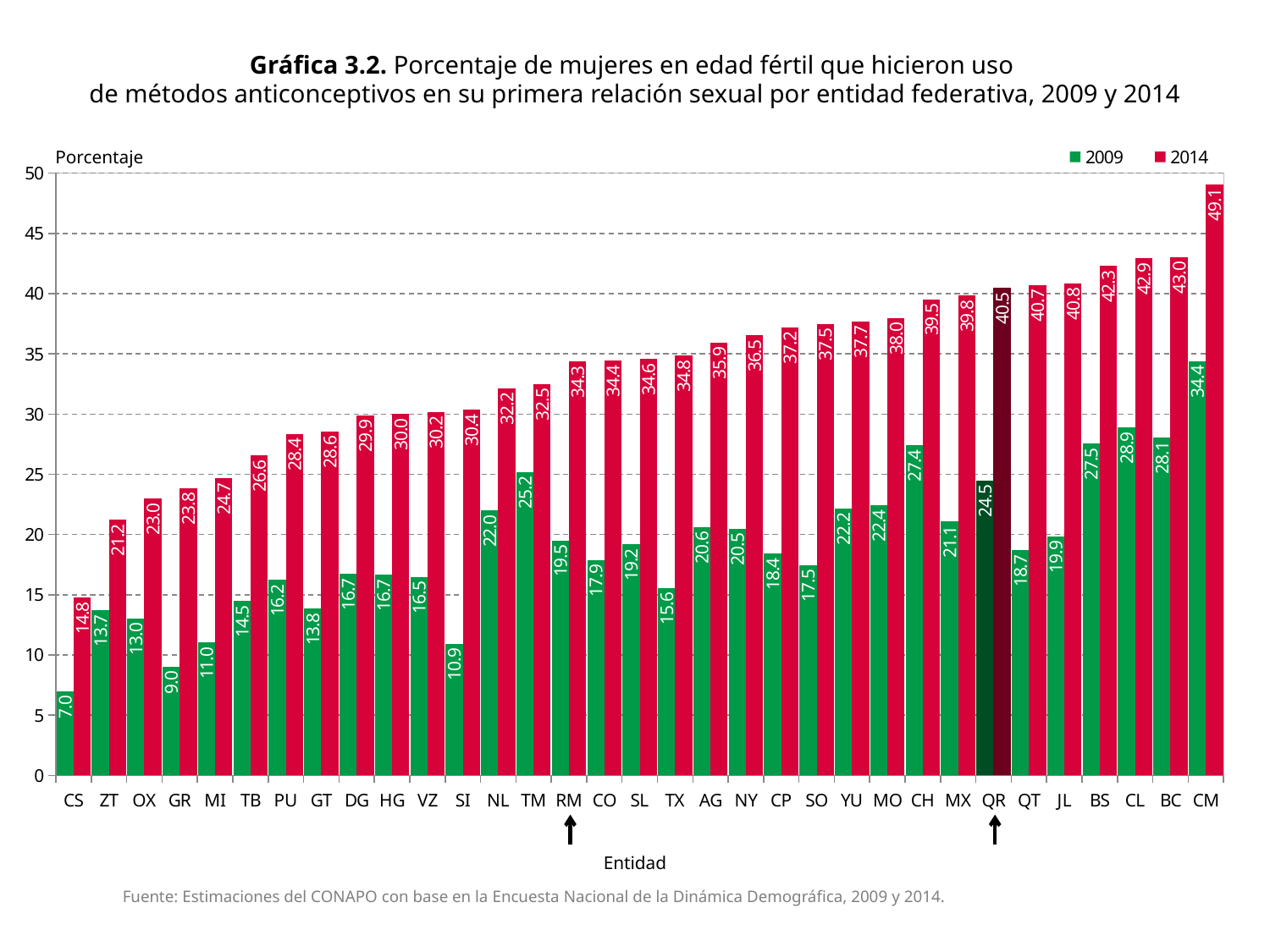
How many series does the legend list? 2 What is the 2014 value for CM? 49.1 Which entity has the lowest 2009 value? CS What kind of chart is shown? bar chart Which entity has the highest 2014 value? CM Which is larger, the 2009 value for TM or the 2009 value for NL? TM Is the 2014 value for SI greater or less than 30? greater What is the 2014 value for RM? 34.3 What is the 2009 value for QR? 24.5 What is the difference between the 2014 and 2009 values for CS? 7.8 Do the 2014 values rise or fall from left to right along the x axis? rise How many entities are shown on the x axis? 33